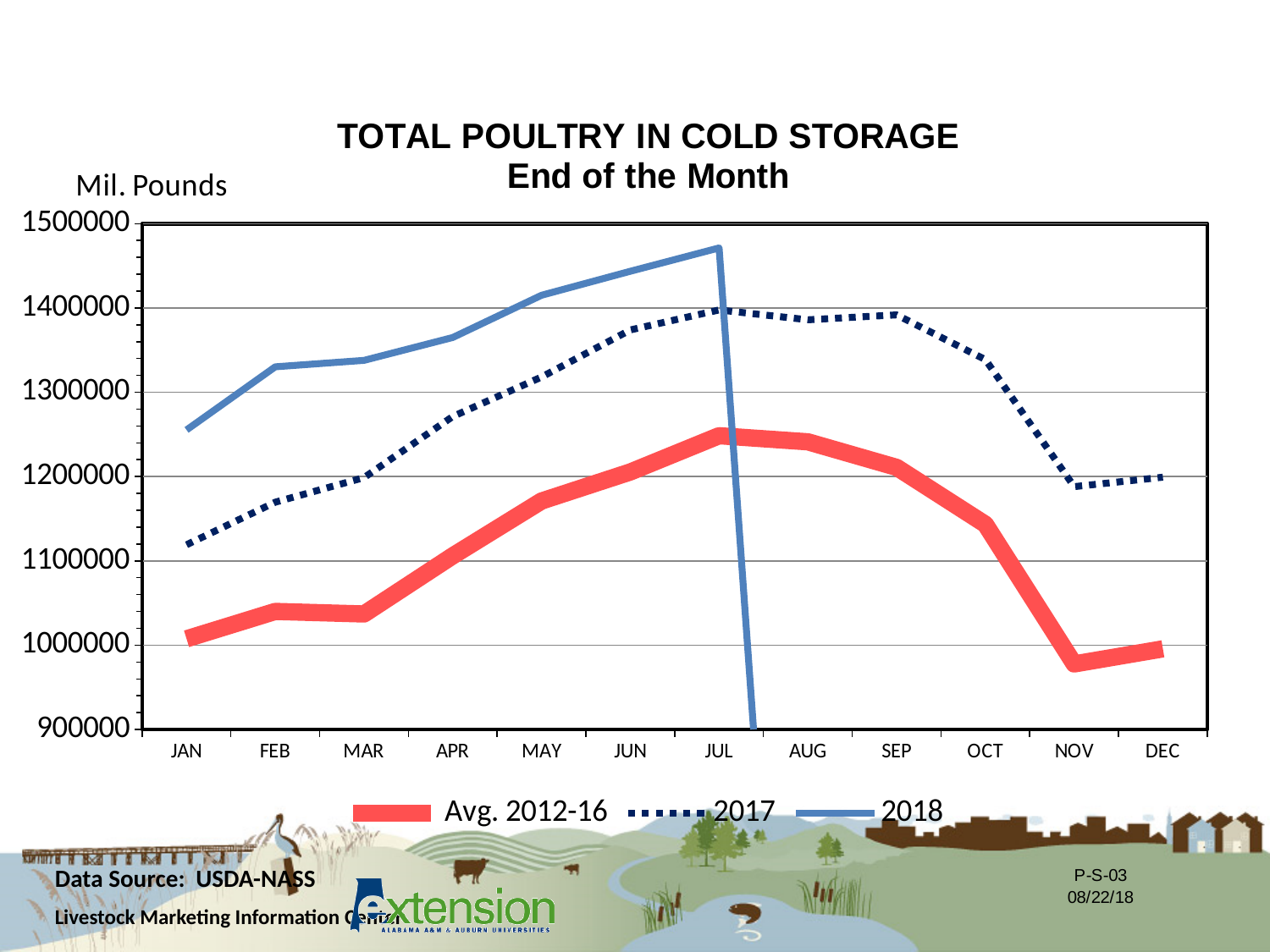
Is the Avg. 2012-16 value for NOV greater or less than 1000000? less Which series has the higher value in JAN, 2018 or 2017? 2018 In which month does the 2018 series reach its highest value? JUL How many months are shown on the x axis? 12 In which month is the 2017 series at its lowest? JAN In which month is the Avg. 2012-16 series at its lowest? NOV What unit is given for the y axis? Mil. Pounds Is the 2017 value for OCT greater or less than 1300000? greater Is the 2018 value for JUL greater or less than 1400000? greater What kind of chart is shown on the slide? line chart How many series does the legend list? 3 Does the 2018 series rise or fall from JAN to JUL? rise